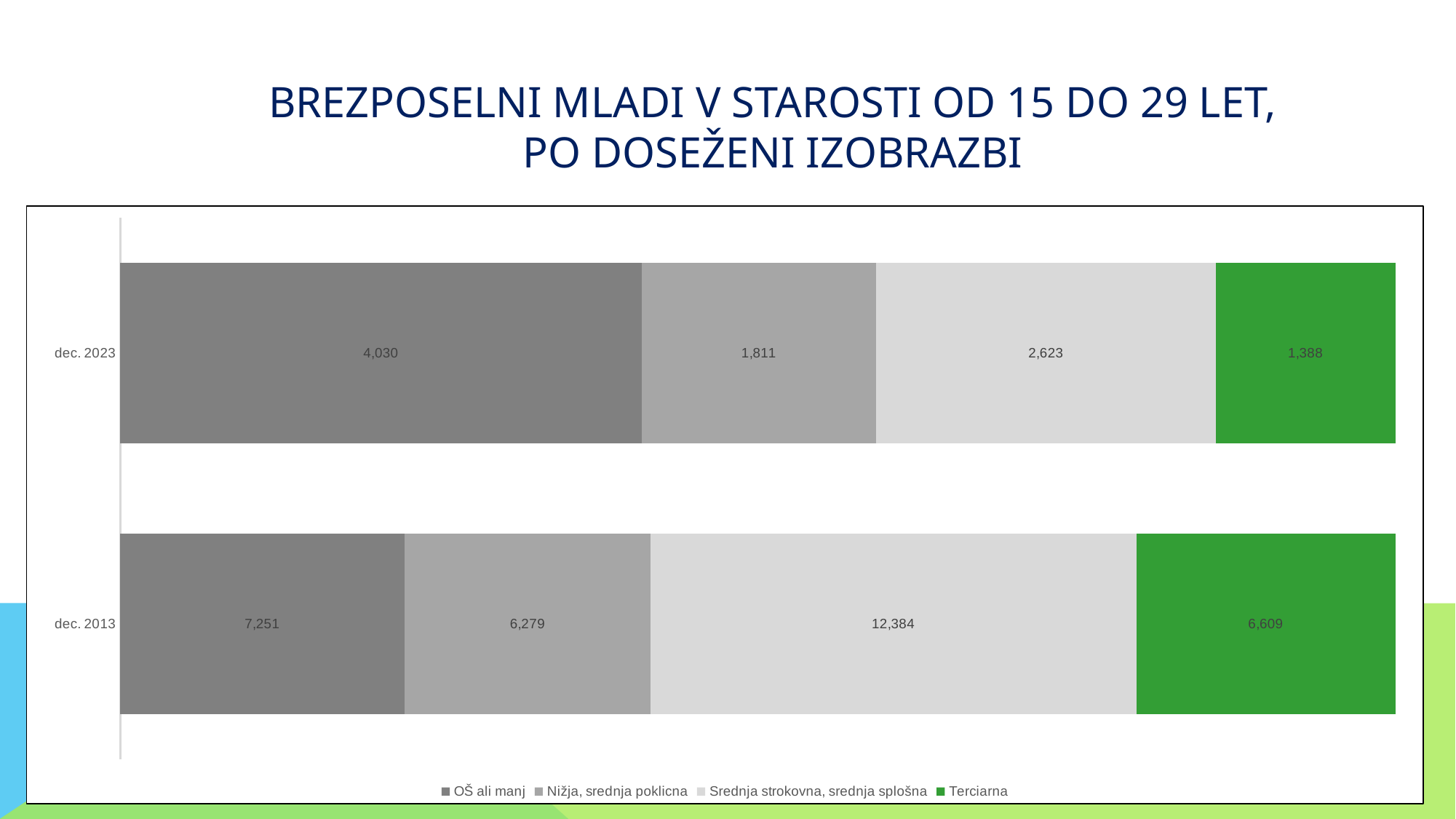
What is the value for 'Nižja, srednja poklicna' in dec. 2013? 6,279 How many series does the legend list? 4 What is the value for 'Terciarna' in dec. 2023? 1,388 Which education group has the lowest value in dec. 2023? Terciarna How many categories (time points) are plotted on the chart? 2 Which is larger: 'Terciarna' in dec. 2013 or 'Terciarna' in dec. 2023? dec. 2013 Which education group has the highest value in dec. 2013? Srednja strokovna, srednja splošna What is the total of the dec. 2023 bar? 9,852 What is the value for 'Srednja strokovna, srednja splošna' in dec. 2013? 12,384 What is the difference between the 'OŠ ali manj' values for dec. 2013 and dec. 2023? 3,221 What is the value for 'OŠ ali manj' in dec. 2023? 4,030 What kind of chart is shown on the slide? stacked bar chart